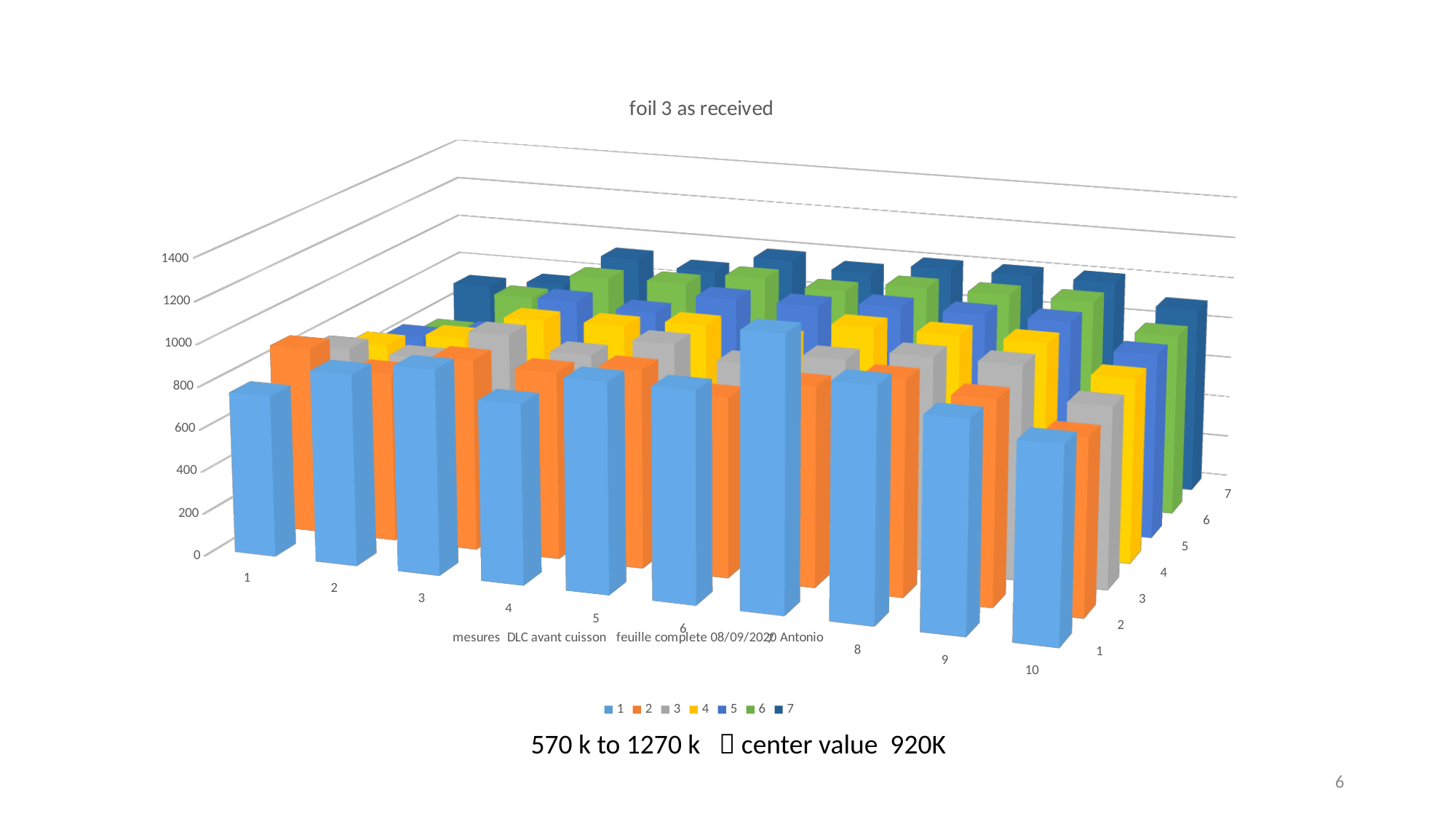
What is the highest value labelled on the vertical axis? 1400 Within series 1 (the front row of blue bars), which category has the shortest bar? 1 How many categories are shown along the x axis of the chart? 10 In series 1, is the bar for category 4 taller or shorter than the bar for category 3? shorter How many series does the legend list? 7 What kind of chart is shown on the slide? bar chart What center value is stated in the text below the chart? 920K What is the title of the chart? foil 3 as received Within series 1 (the front row of blue bars), which category has the tallest bar? 7 In series 1, is the bar for category 7 taller or shorter than the bar for category 10? taller